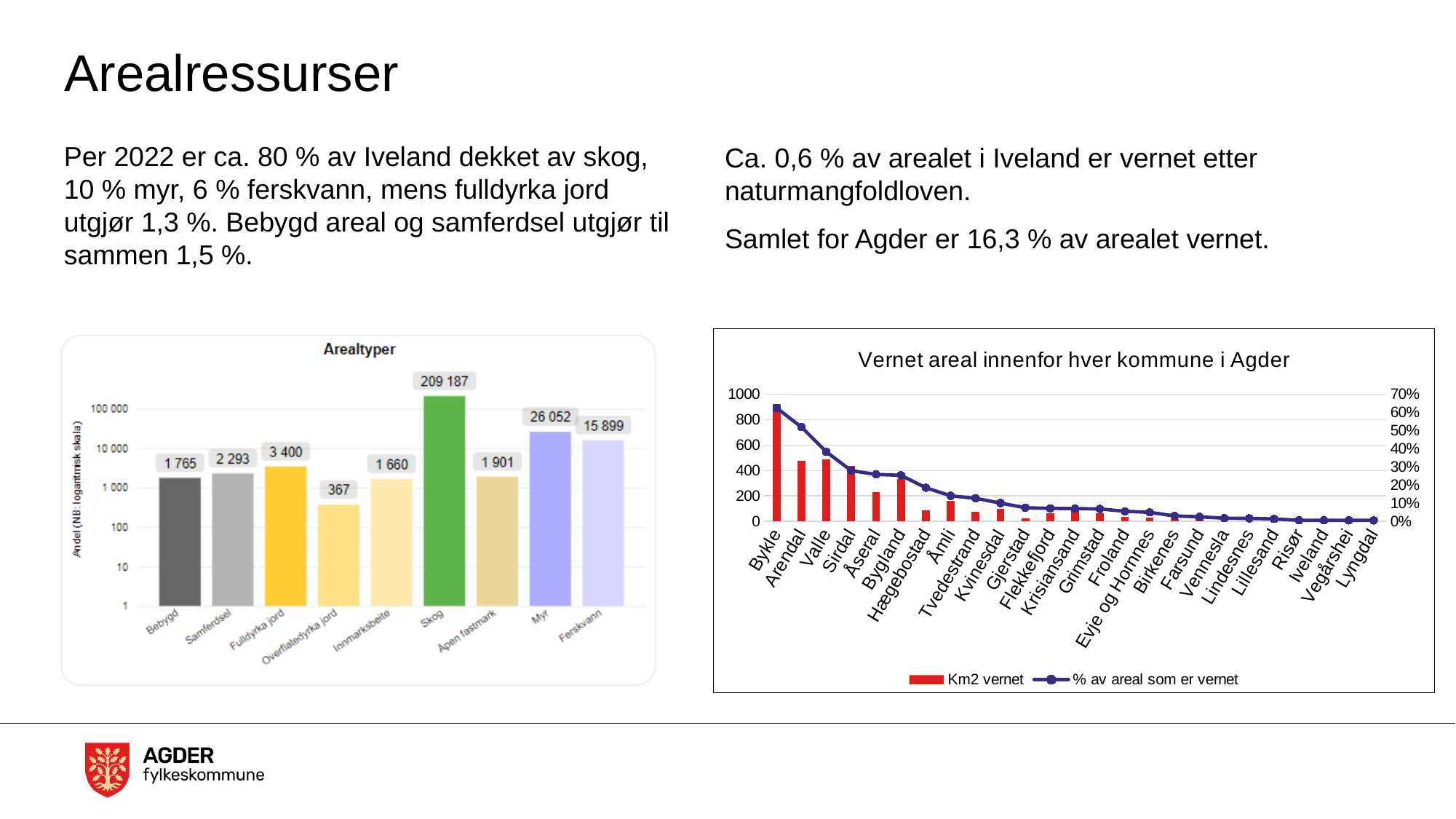
In the chart 'Vernet areal innenfor hver kommune i Agder', which kommune has the highest Km2 vernet? Bykle In the Arealtyper chart, which is larger, Bebygd or Samferdsel? Samferdsel In the Arealtyper chart, which category has the lowest value? Overflatedyrka jord In the chart 'Vernet areal innenfor hver kommune i Agder', how many series does the legend list? 2 In the Arealtyper chart, what is the difference between Myr and Ferskvann? 10 153 In the chart 'Vernet areal innenfor hver kommune i Agder', is the Km2 vernet value for Bykle greater or less than 800? greater In the Arealtyper chart, what is the value for Myr? 26 052 In the chart 'Vernet areal innenfor hver kommune i Agder', does the '% av areal som er vernet' line rise or fall from Bykle to Lyngdal? fall In the Arealtyper chart, what is the value for Overflatedyrka jord? 367 In the Arealtyper chart, which category has the highest value? Skog In the Arealtyper chart, what is the value for Skog? 209 187 How many categories are shown in the Arealtyper chart? 9